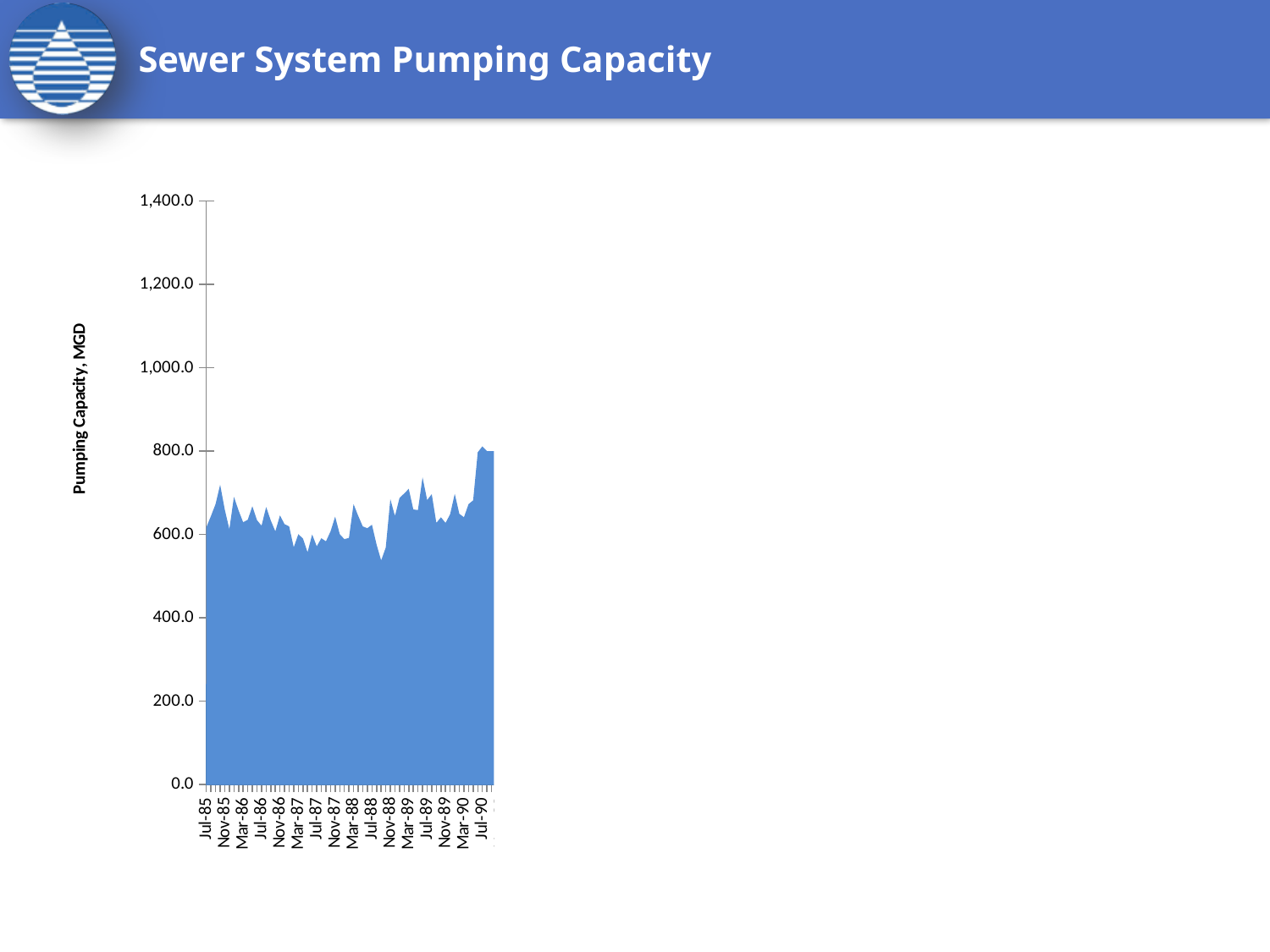
Near which x-axis label does the chart reach its highest value? Jul-90 Is the value for Mar-88 greater or less than 800? less What is the label on the vertical axis of the chart? Pumping Capacity, MGD Is the value for Jul-90 greater or less than 600? greater What is the highest tick value shown on the vertical axis? 1,400.0 Which is larger, the value for Jul-85 or the value for Jul-90? Jul-90 Is the value for Jul-86 greater or less than 1,000? less What is the title of the slide containing the chart? Sewer System Pumping Capacity Comparing the start of the series (Jul-85) with the end (Jul-90), do the values rise or fall overall? rise What kind of chart is shown on the slide? area chart